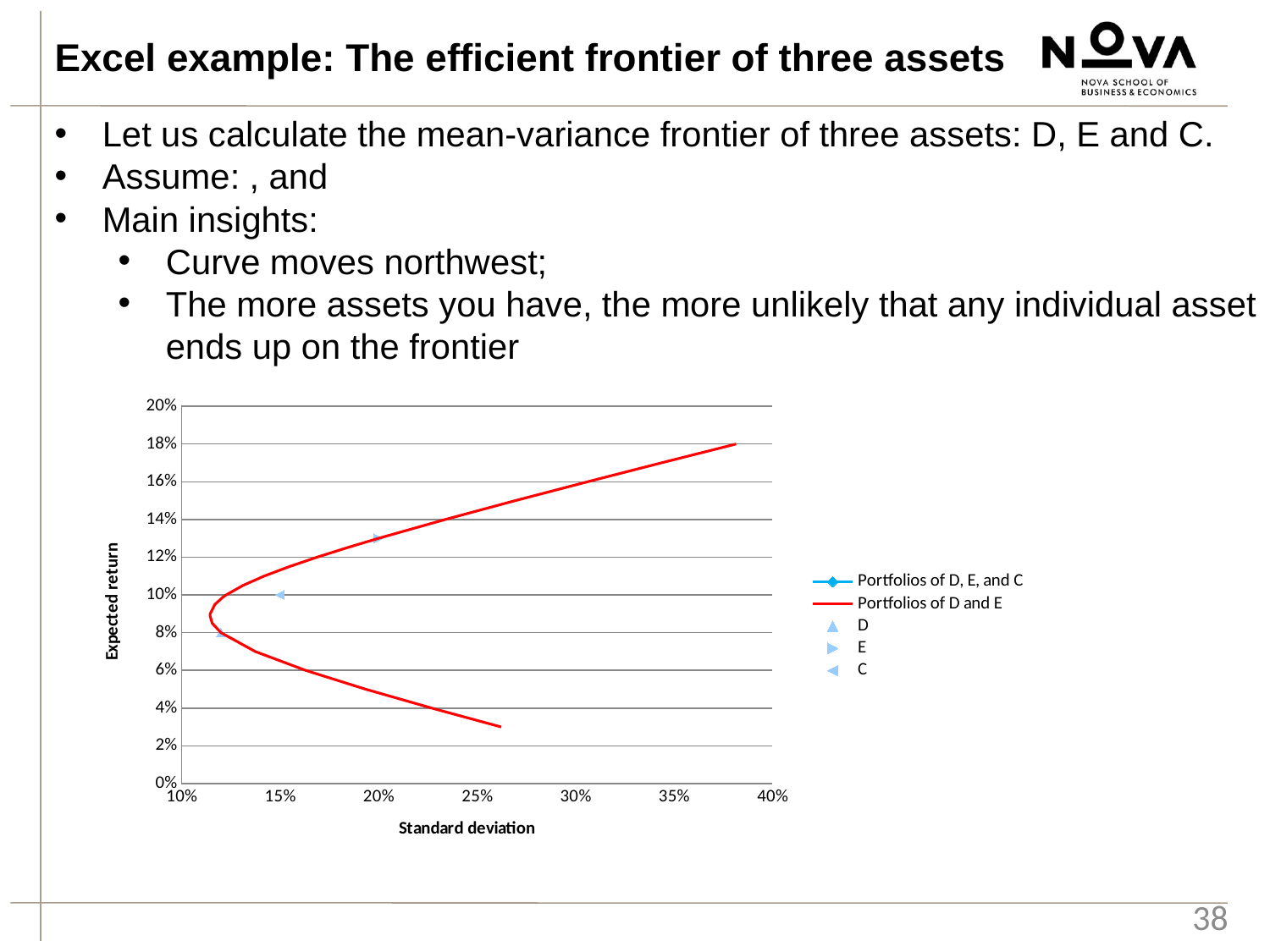
What is the title of the y axis of the chart? Expected return Which asset has the lowest expected return: D, E or C? D What is the standard deviation of asset C in the chart? 15% What is the title of the x axis of the chart? Standard deviation What is the expected return of asset D in the chart? 8% Is the expected return of asset E greater or less than 12%? greater What is the expected return of asset C in the chart? 10% What is the standard deviation of asset E in the chart? 20% Which has the larger standard deviation, asset C or asset E? E Which asset has the highest expected return: D, E or C? E Is the standard deviation of asset D greater or less than 15%? less How many series does the chart's legend list? 5